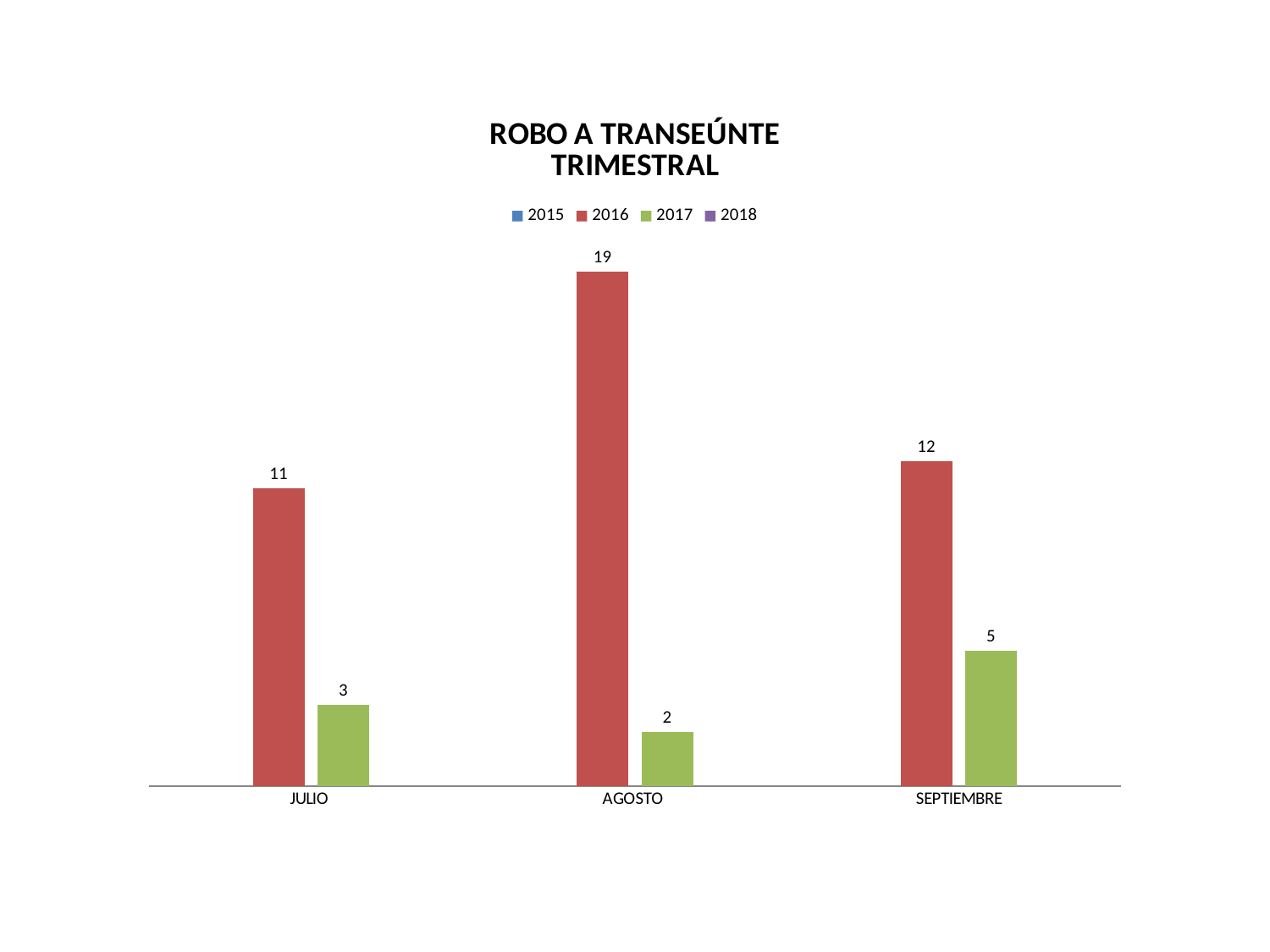
Which month has the lowest value for 2017? AGOSTO Which month has the highest value for 2016? AGOSTO What is the difference between the 2016 values for SEPTIEMBRE and JULIO? 1 How many series does the legend list? 4 What kind of chart is shown? Bar chart How many months are shown on the x axis? 3 Which is larger, the 2017 value for JULIO or the 2017 value for SEPTIEMBRE? SEPTIEMBRE What is the title of the chart? ROBO A TRANSEÚNTE TRIMESTRAL What is the difference between the 2016 and 2017 values in AGOSTO? 17 What is the value for 2016 in AGOSTO? 19 What is the value for 2016 in JULIO? 11 What is the value for 2017 in SEPTIEMBRE? 5